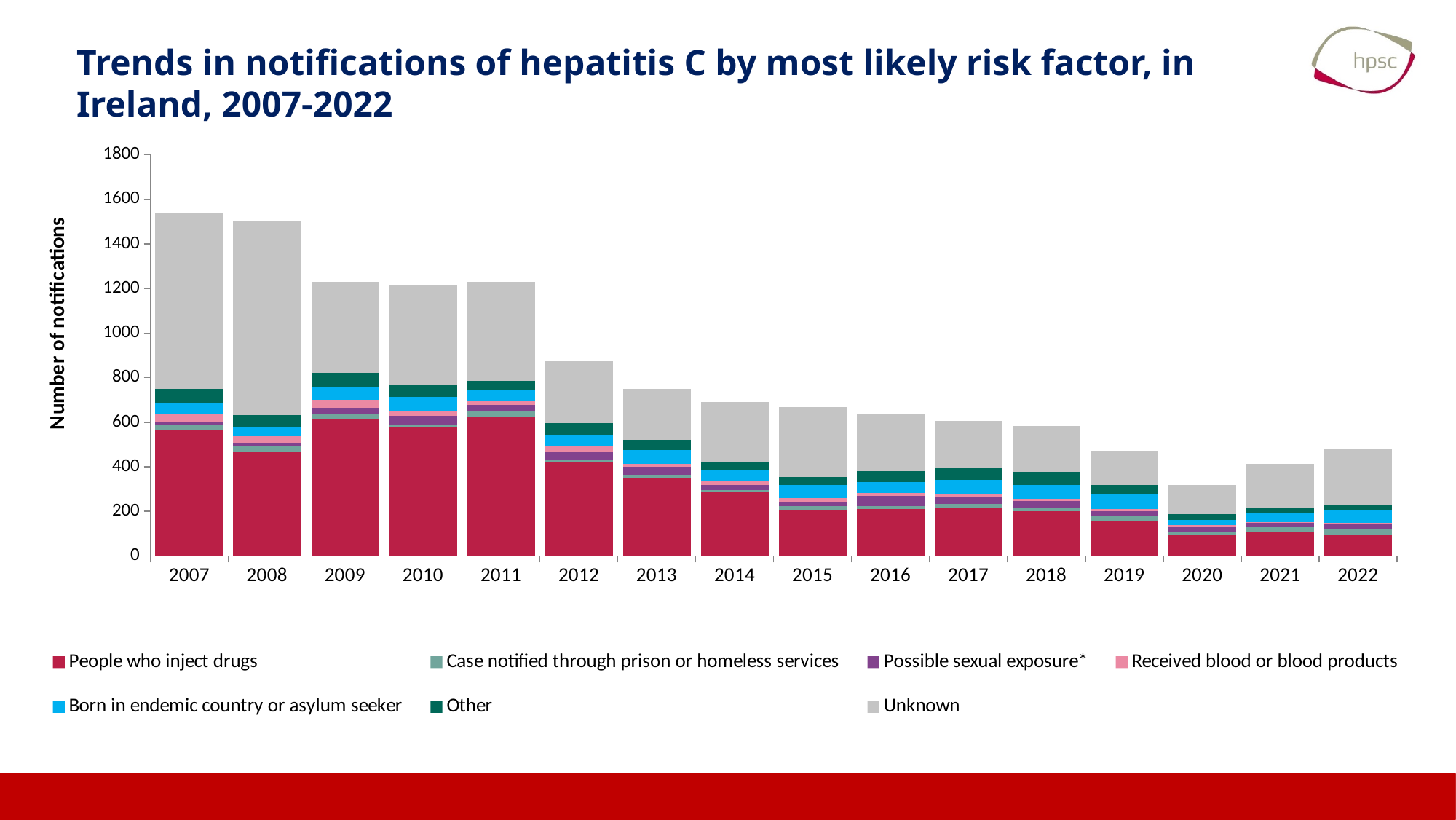
Is the total number of notifications in 2022 greater or less than 600? less How many risk factor series does the legend list? 7 Which year has the lowest total number of notifications? 2020 Do total notifications generally rise or fall from 2007 to 2020? fall Is the total number of notifications in 2020 greater or less than 400? less What is the title of the vertical axis? Number of notifications Which year has a higher total number of notifications, 2021 or 2022? 2022 Is the total number of notifications in 2012 greater or less than 800? greater How many years are shown along the x axis of the chart? 16 What kind of chart is shown on the slide? Stacked bar chart Which year has the highest total number of notifications? 2007